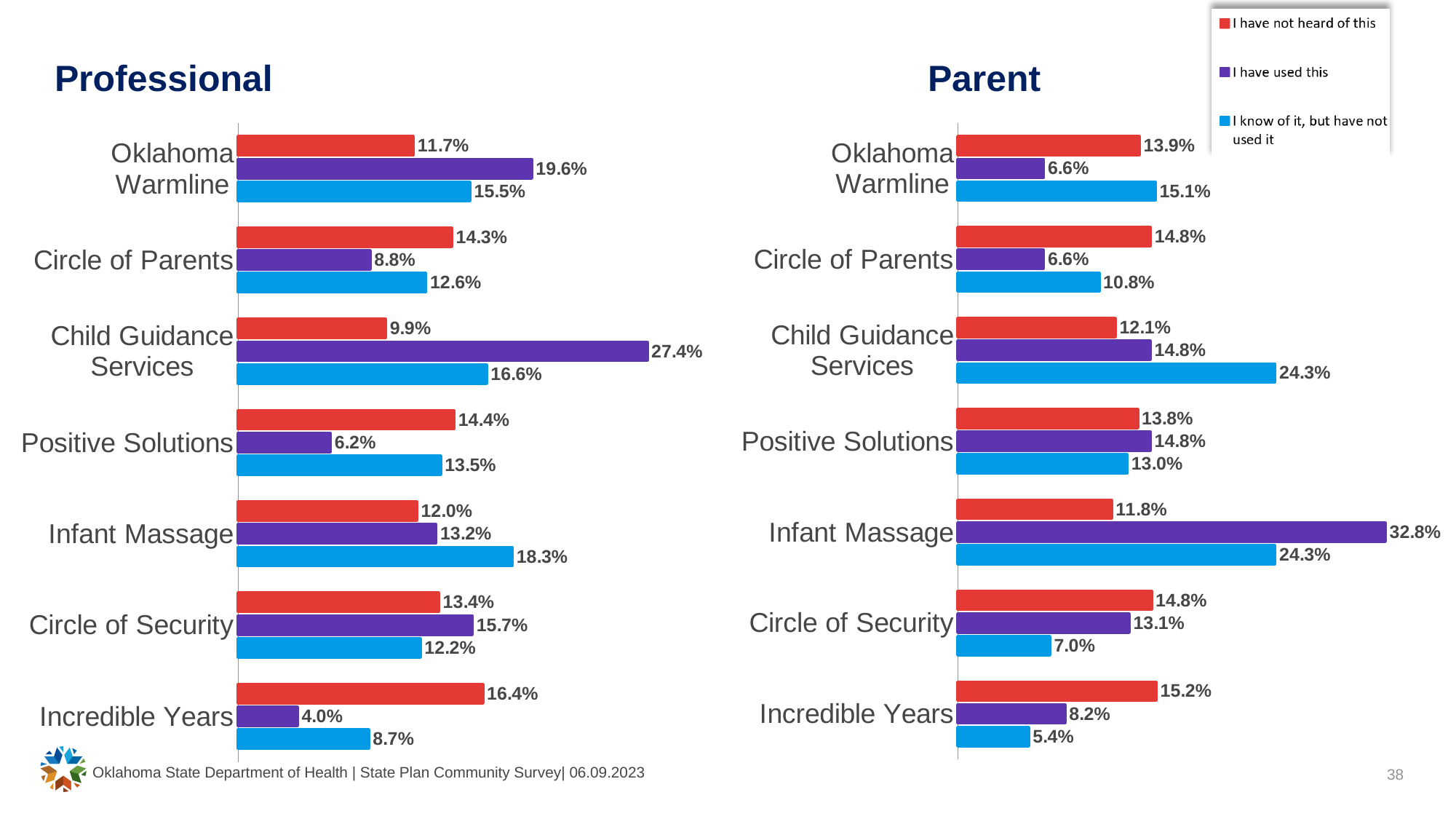
What kind of chart is the Parent chart? Bar chart In the Parent chart, which is larger for Oklahoma Warmline: 'I have not heard of this' or 'I have used this'? I have not heard of this In the Parent chart, what is the value for 'I know of it, but have not used it' for Circle of Security? 7.0% In the Professional chart, what is the difference between 'I have not heard of this' and 'I know of it, but have not used it' for Incredible Years? 7.7% How many programs are listed in the Professional chart? 7 In the Professional chart, what is the difference between 'I have used this' and 'I have not heard of this' for Child Guidance Services? 17.5% Which colour represents 'I have used this' in the legend? Purple How many series does the legend list? 3 In the Parent chart, what is the value for 'I have used this' for Infant Massage? 32.8% In the Professional chart, which program has the lowest value for 'I have used this'? Incredible Years In the Parent chart, which program has the highest value for 'I have used this'? Infant Massage In the Professional chart, what is the value for 'I have used this' for Child Guidance Services? 27.4%